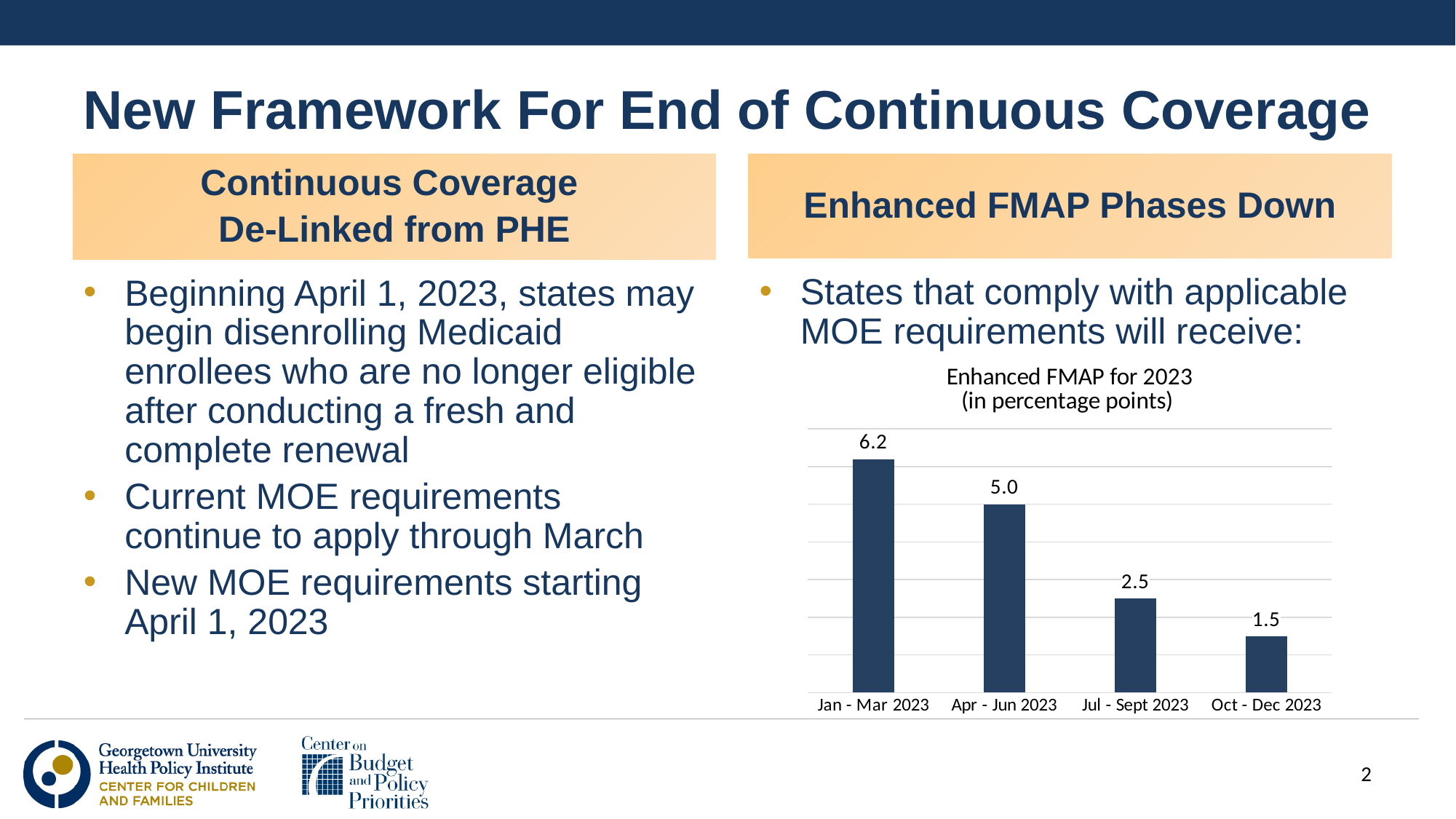
What is the enhanced FMAP value for Jan - Mar 2023? 6.2 What is the enhanced FMAP value for Oct - Dec 2023? 1.5 Do the enhanced FMAP values rise or fall across the quarters of 2023? Fall Which is larger, the enhanced FMAP value for Apr - Jun 2023 or for Jul - Sept 2023? Apr - Jun 2023 What is the difference between the enhanced FMAP values for Jul - Sept 2023 and Oct - Dec 2023? 1.0 Which quarter has the highest enhanced FMAP value? Jan - Mar 2023 What is the enhanced FMAP value for Apr - Jun 2023? 5.0 What is the difference between the enhanced FMAP values for Jan - Mar 2023 and Apr - Jun 2023? 1.2 What is the enhanced FMAP value for Jul - Sept 2023? 2.5 How many quarters are shown in the chart? 4 Which quarter has the lowest enhanced FMAP value? Oct - Dec 2023 What kind of chart is used to show the enhanced FMAP for 2023? Bar chart